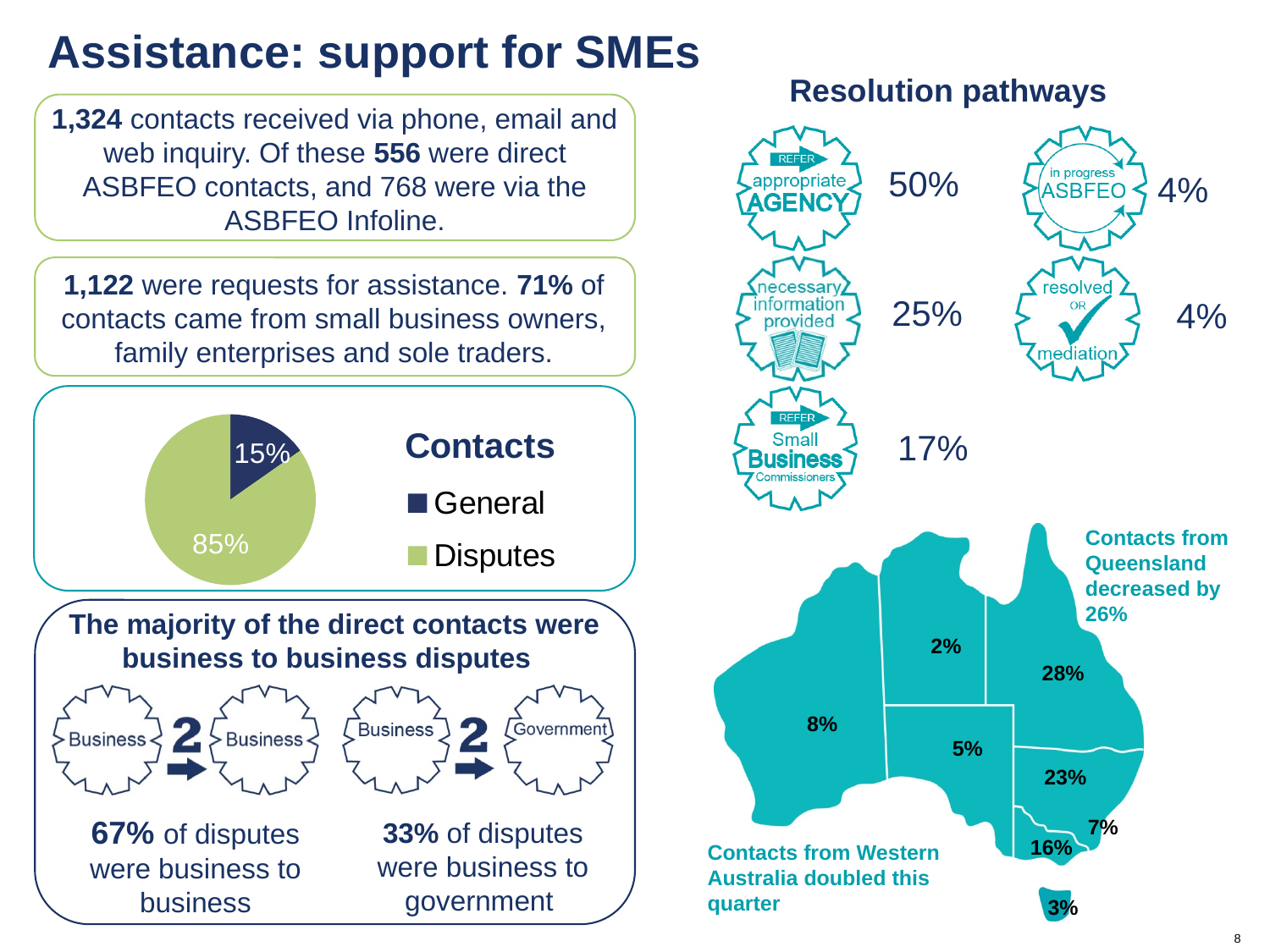
In the "Contacts" pie chart, which category has the largest slice? Disputes In the "Contacts" pie chart, what share of contacts is Disputes? 85% How many entries does the legend of the "Contacts" pie chart list? 2 What kind of chart is the "Contacts" chart on the slide? pie chart In the "Contacts" pie chart, what colour is the Disputes slice? green In the "Contacts" pie chart, what is the difference in percentage points between Disputes and General? 70 In the "Contacts" pie chart, what share of contacts is General? 15% In the "Contacts" pie chart, which is larger, General or Disputes? Disputes What is the title of the pie chart on the slide? Contacts In the "Contacts" pie chart, which category has the smallest slice? General How many categories does the "Contacts" pie chart show? 2